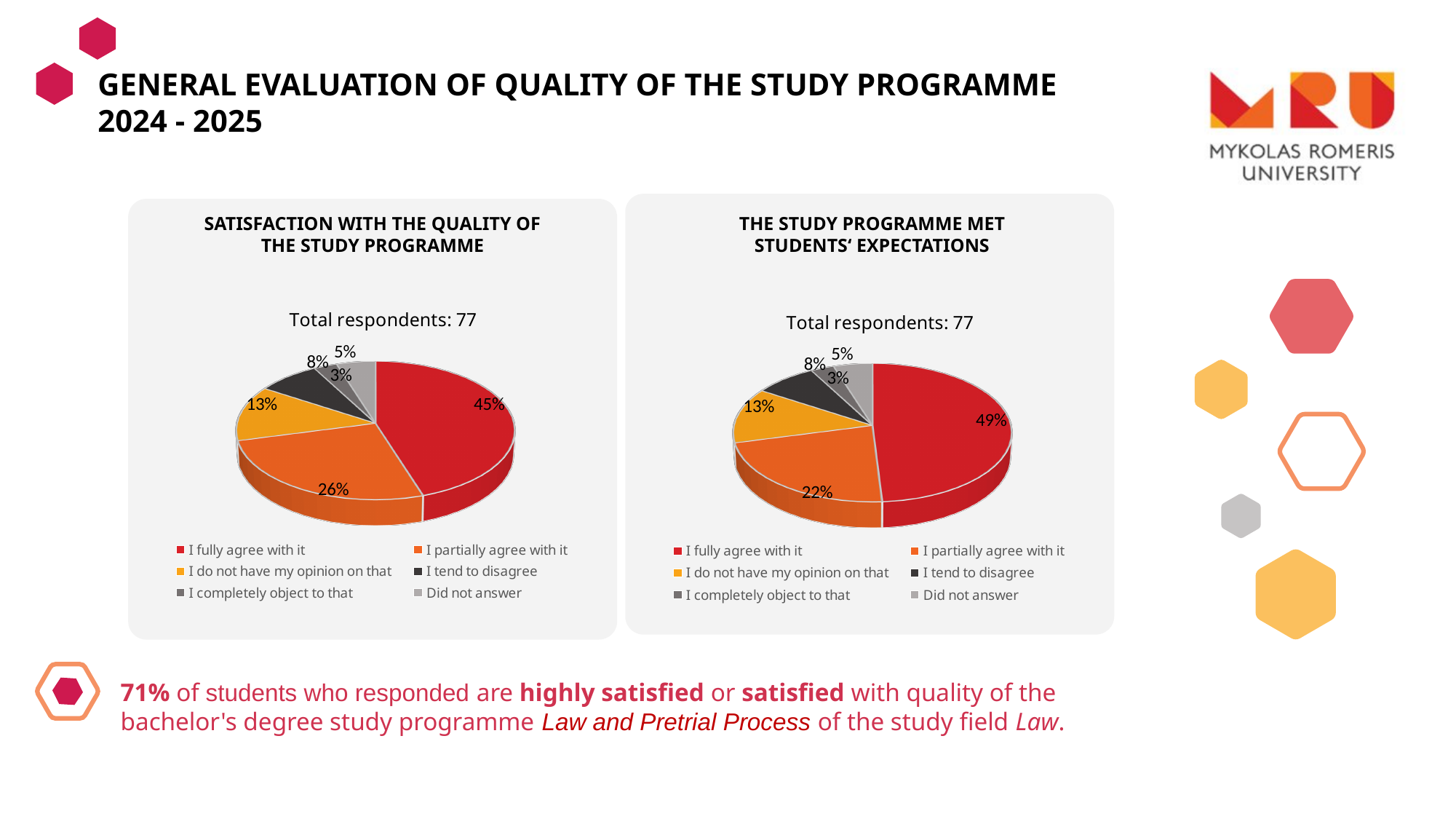
In the 'The study programme met students' expectations' chart, what share of respondents chose 'I tend to disagree'? 8% In the 'Satisfaction with the quality of the study programme' chart, which response has the largest share? I fully agree with it Which chart has the larger share for 'I fully agree with it', the left one or the right one? The right one (The study programme met students' expectations) In the 'The study programme met students' expectations' chart, what share of respondents chose 'I fully agree with it'? 49% In the 'Satisfaction with the quality of the study programme' chart, what share of respondents chose 'I partially agree with it'? 26% In the 'Satisfaction with the quality of the study programme' chart, what is the difference between the 'I fully agree with it' and 'I partially agree with it' shares? 19% In the 'The study programme met students' expectations' chart, what share of respondents chose 'I partially agree with it'? 22% In the 'The study programme met students' expectations' chart, what is the difference between the 'I fully agree with it' and 'I partially agree with it' shares? 27% What type of chart is used in the 'Satisfaction with the quality of the study programme' panel? Pie chart In the 'Satisfaction with the quality of the study programme' chart, what share of respondents chose 'I fully agree with it'? 45% In the 'The study programme met students' expectations' chart, which response has the largest share? I fully agree with it How many response categories does the legend of the 'The study programme met students' expectations' chart list? 6